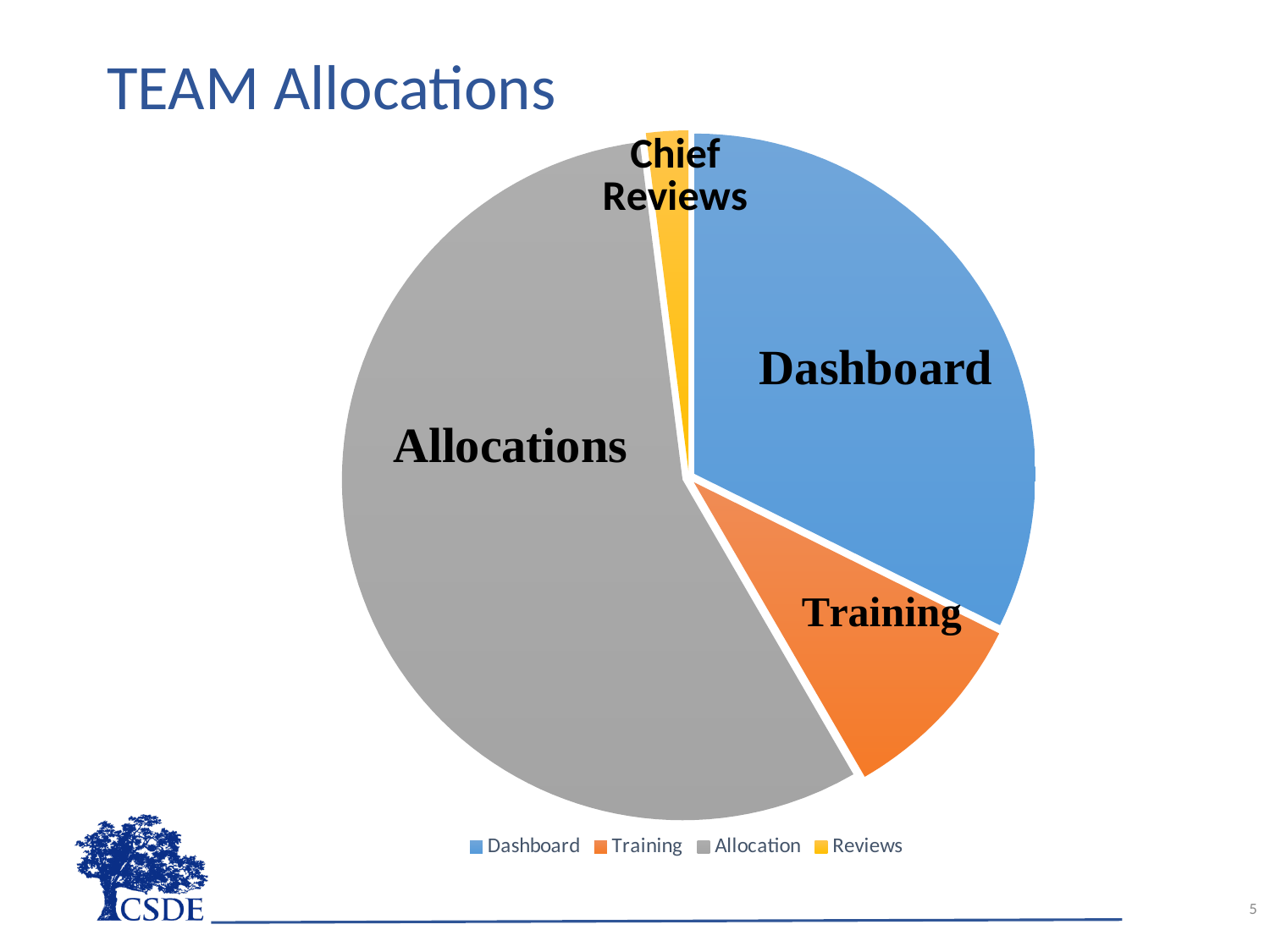
What kind of chart is shown on the slide? pie chart Which slice is larger, Dashboard or Training? Dashboard How many slices does the pie chart have? 4 What colour is the Allocation slice in the pie chart? gray What is the title of the slide containing the pie chart? TEAM Allocations Which slice of the pie chart is the largest? Allocation Which slice is larger, Allocation or Training? Allocation Which slice of the pie chart is the smallest? Reviews Which slice is larger, Training or Reviews? Training How many entries does the legend of the pie chart list? 4